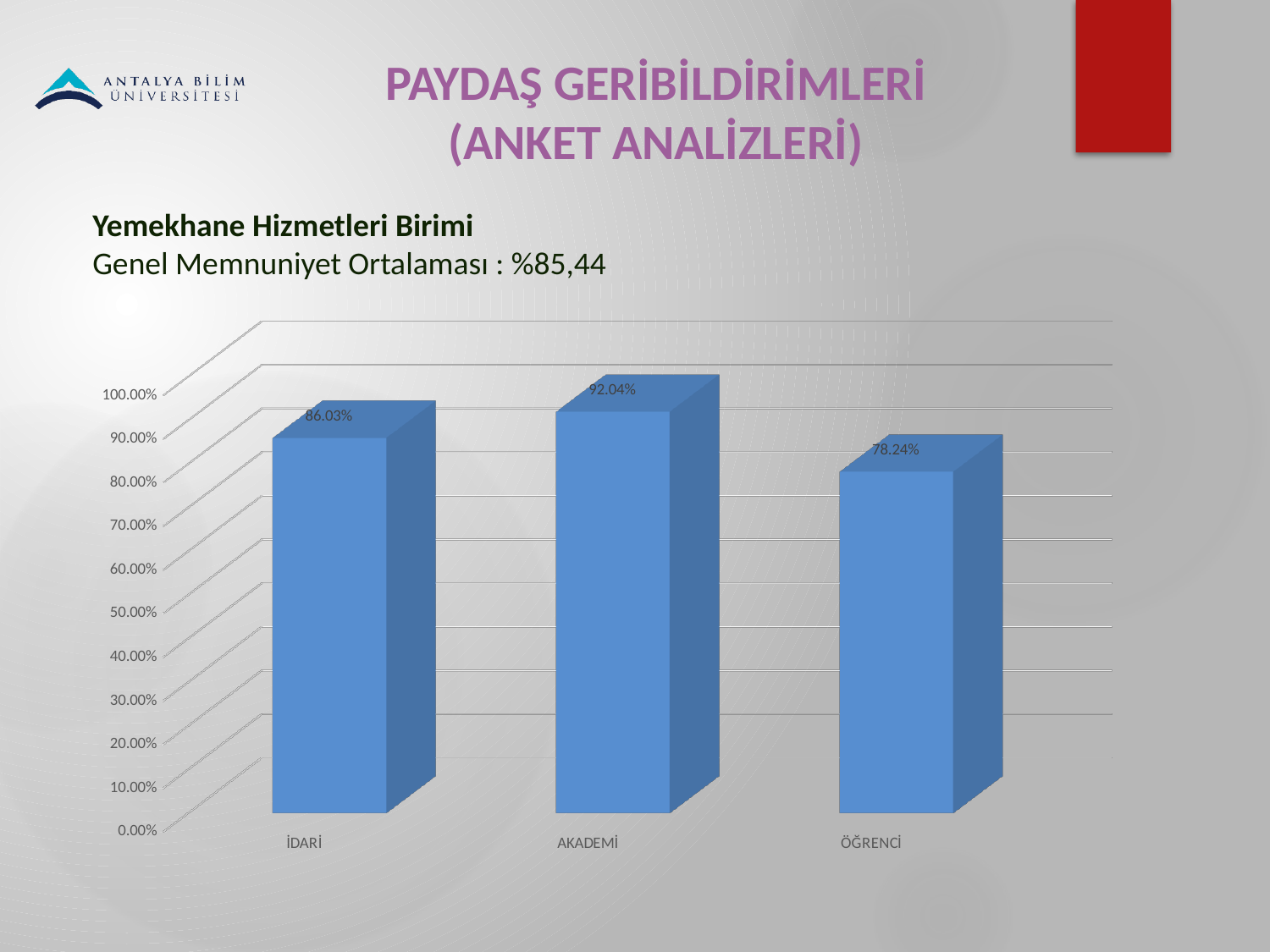
Which category has the highest value? AKADEMİ How many categories are shown on the chart? 3 What kind of chart is shown on the slide? bar chart Which is larger, the value for İDARİ or the value for ÖĞRENCİ? İDARİ What is the difference between the values for İDARİ and ÖĞRENCİ? 7.79% What is the difference between the values for AKADEMİ and İDARİ? 6.01% Is the value for ÖĞRENCİ greater or less than 80.00%? less What is the value for ÖĞRENCİ? 78.24% What is the value for İDARİ? 86.03% What is the value for AKADEMİ? 92.04% What is the overall satisfaction average (Genel Memnuniyet Ortalaması) stated above the chart? %85,44 Which category has the lowest value? ÖĞRENCİ